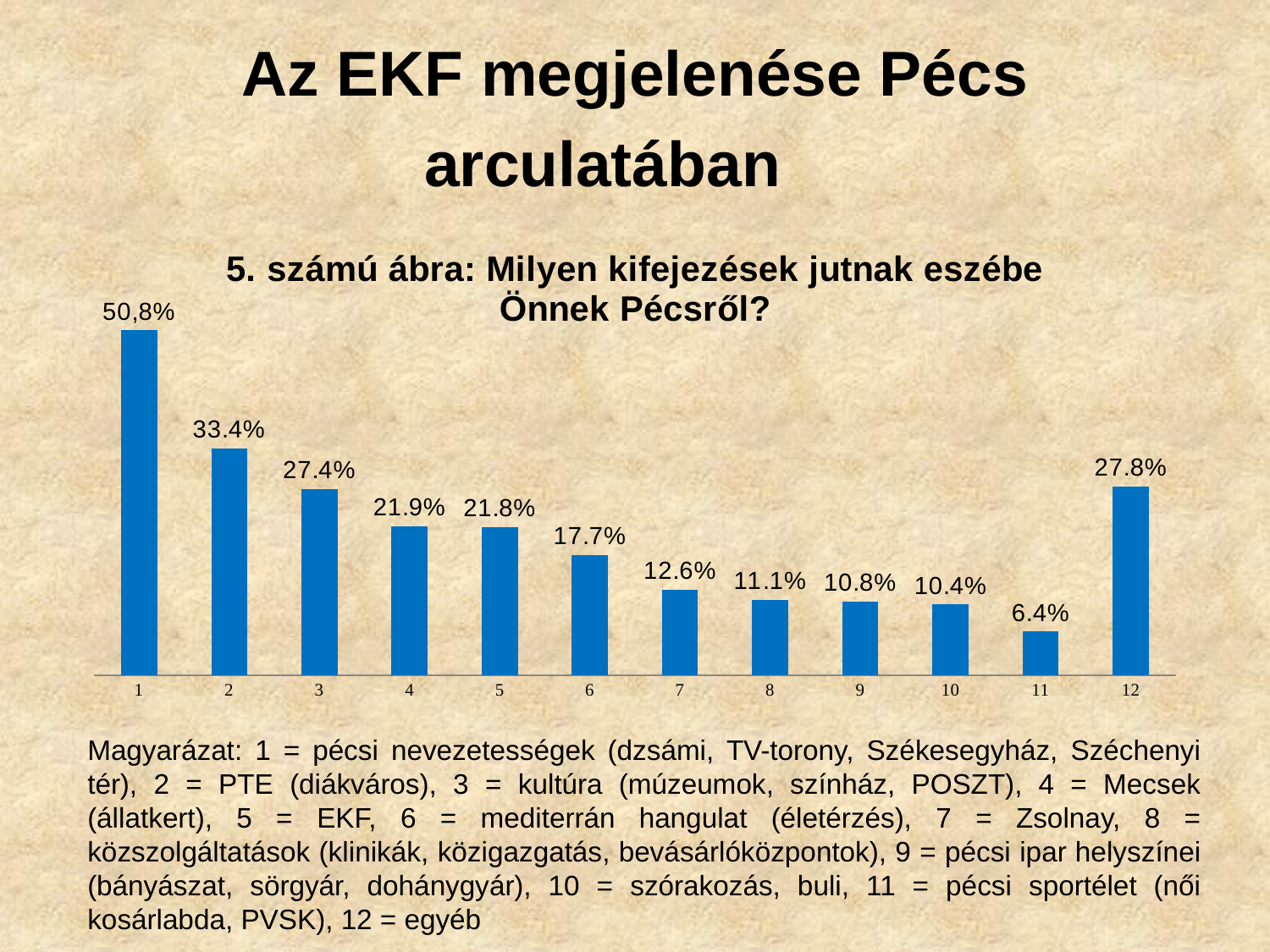
What is the difference between the values for category 2 and category 3? 6.0% How many categories are shown on the x axis? 12 What is the title of the chart? 5. számú ábra: Milyen kifejezések jutnak eszébe Önnek Pécsről? What is the difference between the values for category 12 and category 11? 21.4% What is the value for category 1? 50,8% What is the value for category 5? 21.8% What kind of chart is shown on the slide? Bar chart Which has the larger value, category 6 or category 7? Category 6 Which category has the highest value? 1 What is the value for category 12? 27.8% What is the value for category 8? 11.1% Which category has the lowest value? 11